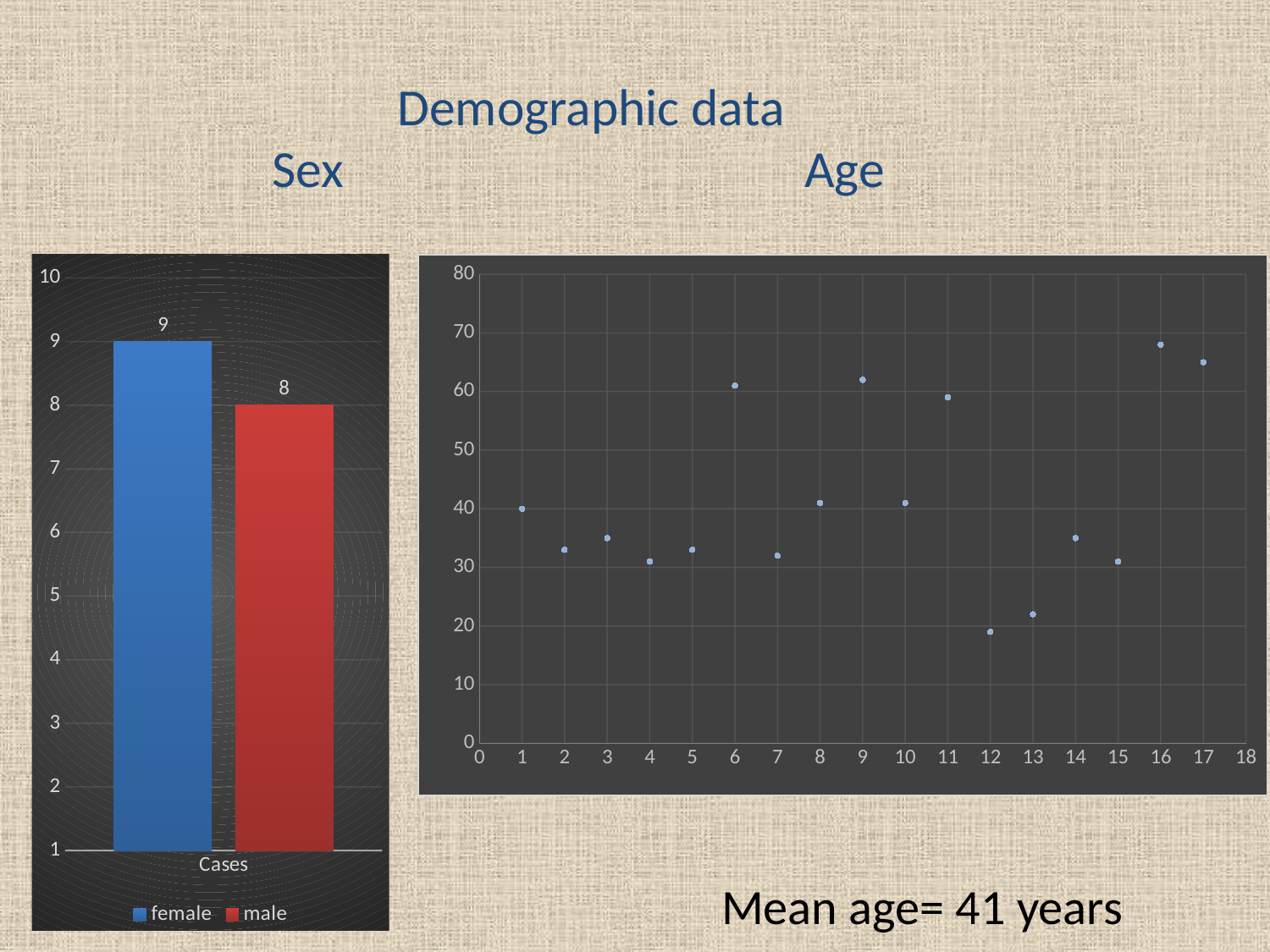
In the Age chart, is the value for point 16 greater or less than 60? greater In the Sex chart, which series has the higher value, female or male? female In the Sex chart, what colour is the male bar? red What kind of chart is the Sex chart? bar chart In the Sex chart, what is the difference between the female and male values? 1 In the Sex chart, how many series does the legend list? 2 What kind of chart is the Age chart? scatter chart In the Age chart, is the value for point 13 greater or less than 30? less In the Age chart, is the value for point 6 greater or less than 50? greater In the Sex chart, what is the value for male? 8 In the Sex chart, what is the value for female? 9 In the Age chart, how many data points are plotted? 17